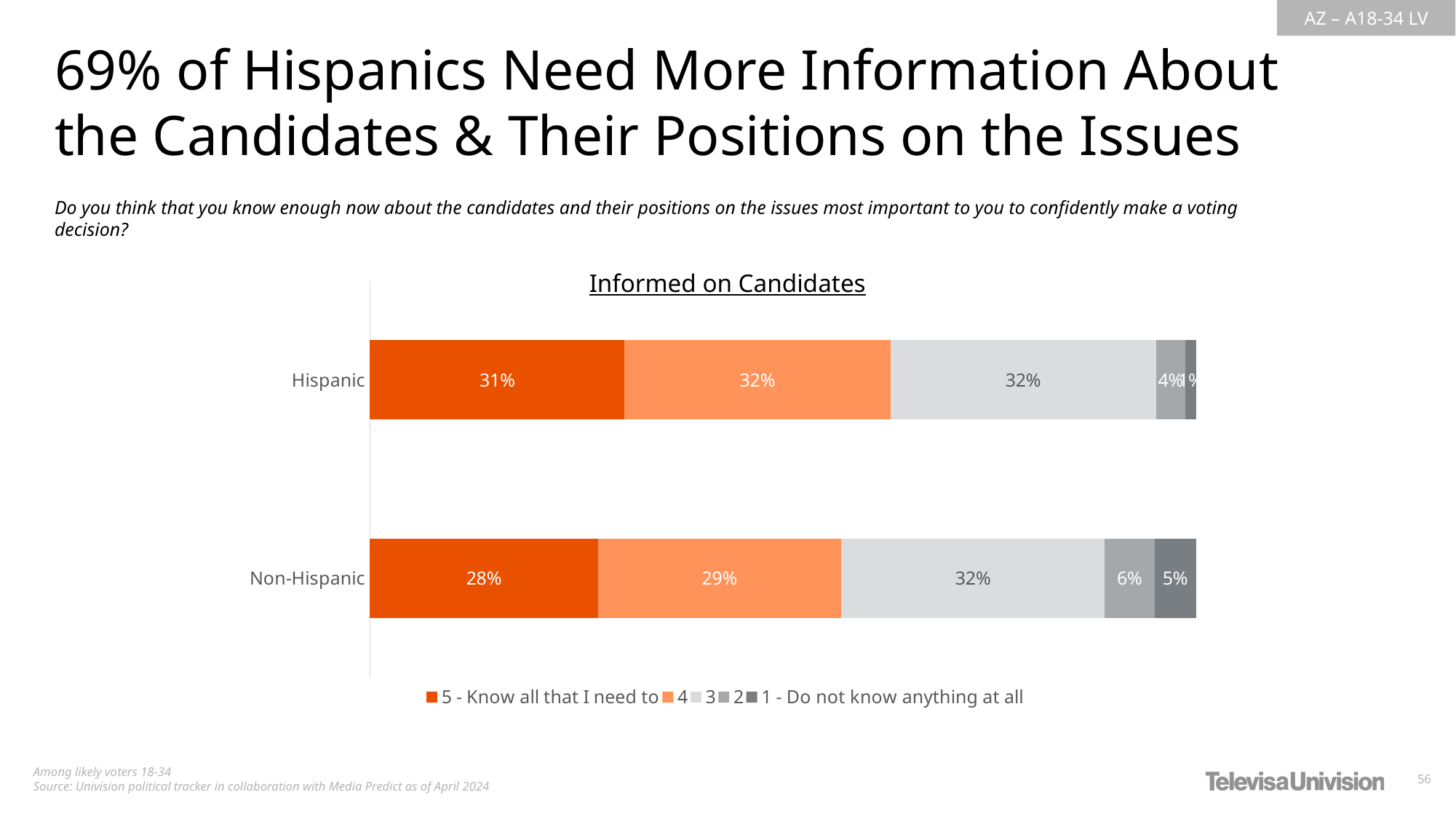
What percentage of Non-Hispanic respondents chose "4"? 29% How many groups (categories) are shown in the chart? 2 What percentage of Hispanic respondents chose "3"? 32% What is the title of the chart? Informed on Candidates What percentage of Non-Hispanic respondents chose "2"? 6% Which group has the larger share for "5 - Know all that I need to", Hispanic or Non-Hispanic? Hispanic What percentage of Hispanic respondents chose "5 - Know all that I need to"? 31% For Non-Hispanic respondents, which is larger, the share for "3" or the share for "2"? 3 What percentage of Non-Hispanic respondents chose "1 - Do not know anything at all"? 5% How many percentage points higher is the Hispanic share for "5 - Know all that I need to" than the Non-Hispanic share? 3 percentage points How many series does the legend list? 5 What type of chart is shown on the slide? Stacked bar chart